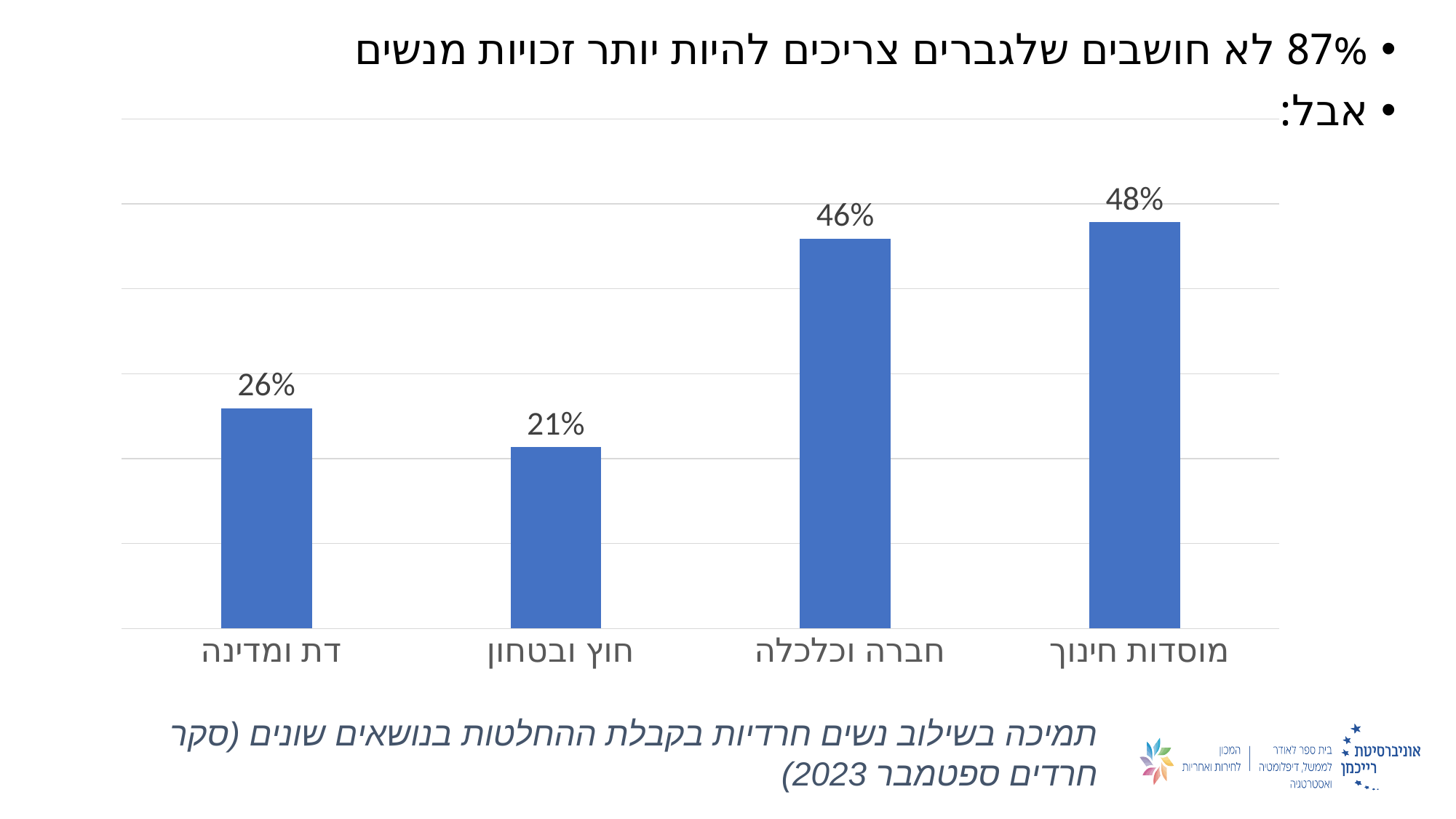
What is the difference between the values for דת ומדינה and חוץ ובטחון? 5% What is the value for דת ומדינה? 26% What colour are the bars in the chart? Blue What is the value for מוסדות חינוך? 48% Which category has the lowest value? חוץ ובטחון How many categories are shown in the chart? 4 What kind of chart is shown on the slide? Bar chart Which is larger, the value for דת ומדינה or the value for חוץ ובטחון? דת ומדינה What is the value for חברה וכלכלה? 46% What is the value for חוץ ובטחון? 21% What is the difference between the values for מוסדות חינוך and חוץ ובטחון? 27% Which category has the highest value? מוסדות חינוך